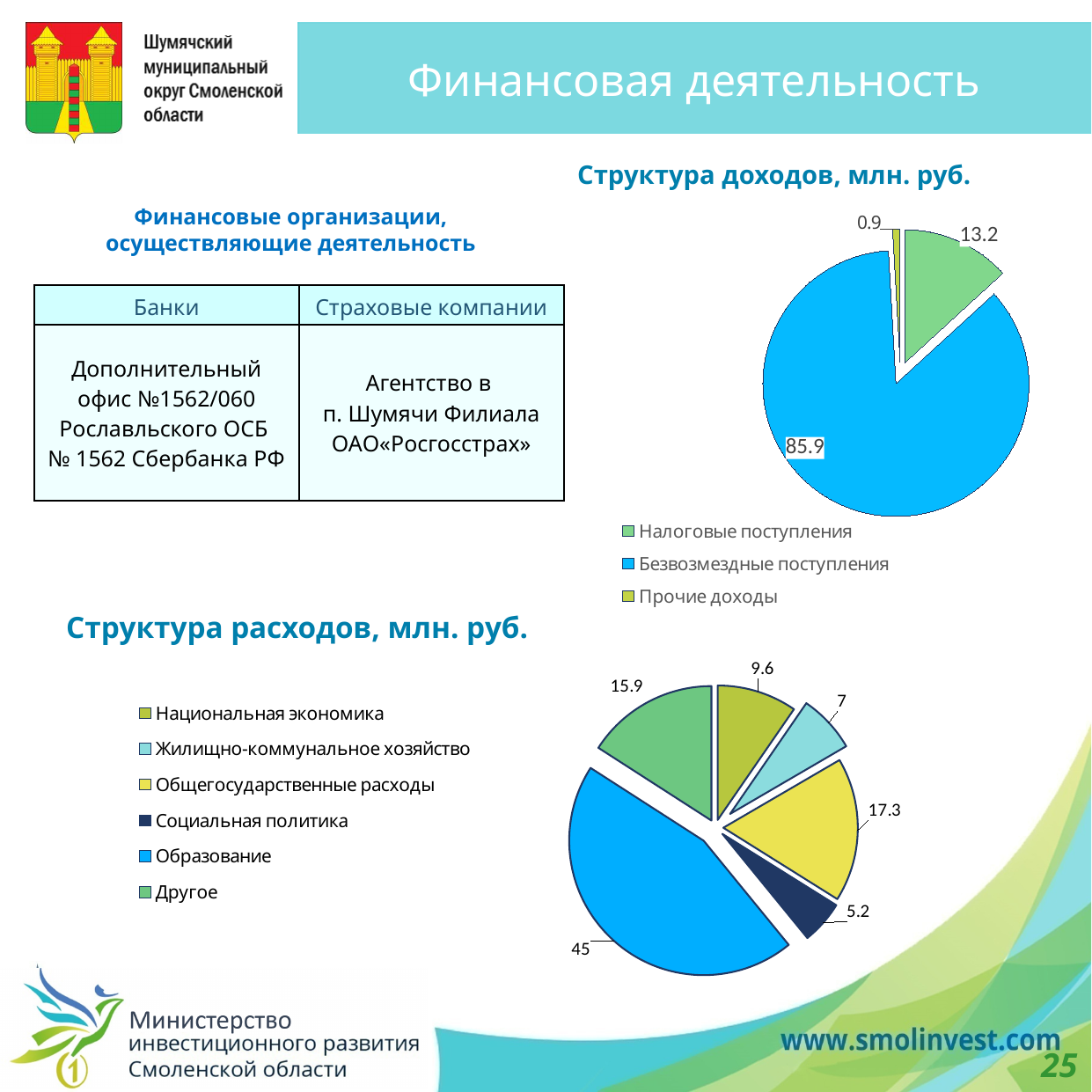
What type of chart is used for 'Структура расходов, млн. руб.'? Pie chart On the chart 'Структура доходов, млн. руб.', which category has the smallest value? Прочие доходы On the chart 'Структура расходов, млн. руб.', what is the value for Общегосударственные расходы? 17.3 On the chart 'Структура расходов, млн. руб.', how many categories are shown? 6 On the chart 'Структура доходов, млн. руб.', how many categories does the legend list? 3 On the chart 'Структура расходов, млн. руб.', which category has the smallest value? Социальная политика On the chart 'Структура доходов, млн. руб.', what is the difference between Безвозмездные поступления and Налоговые поступления? 72.7 On the chart 'Структура расходов, млн. руб.', which is larger: Национальная экономика or Жилищно-коммунальное хозяйство? Национальная экономика On the chart 'Структура расходов, млн. руб.', which category has the largest value? Образование On the chart 'Структура доходов, млн. руб.', what is the value for Безвозмездные поступления? 85.9 On the chart 'Структура доходов, млн. руб.', what is the value for Налоговые поступления? 13.2 On the chart 'Структура расходов, млн. руб.', what is the value for Образование? 45